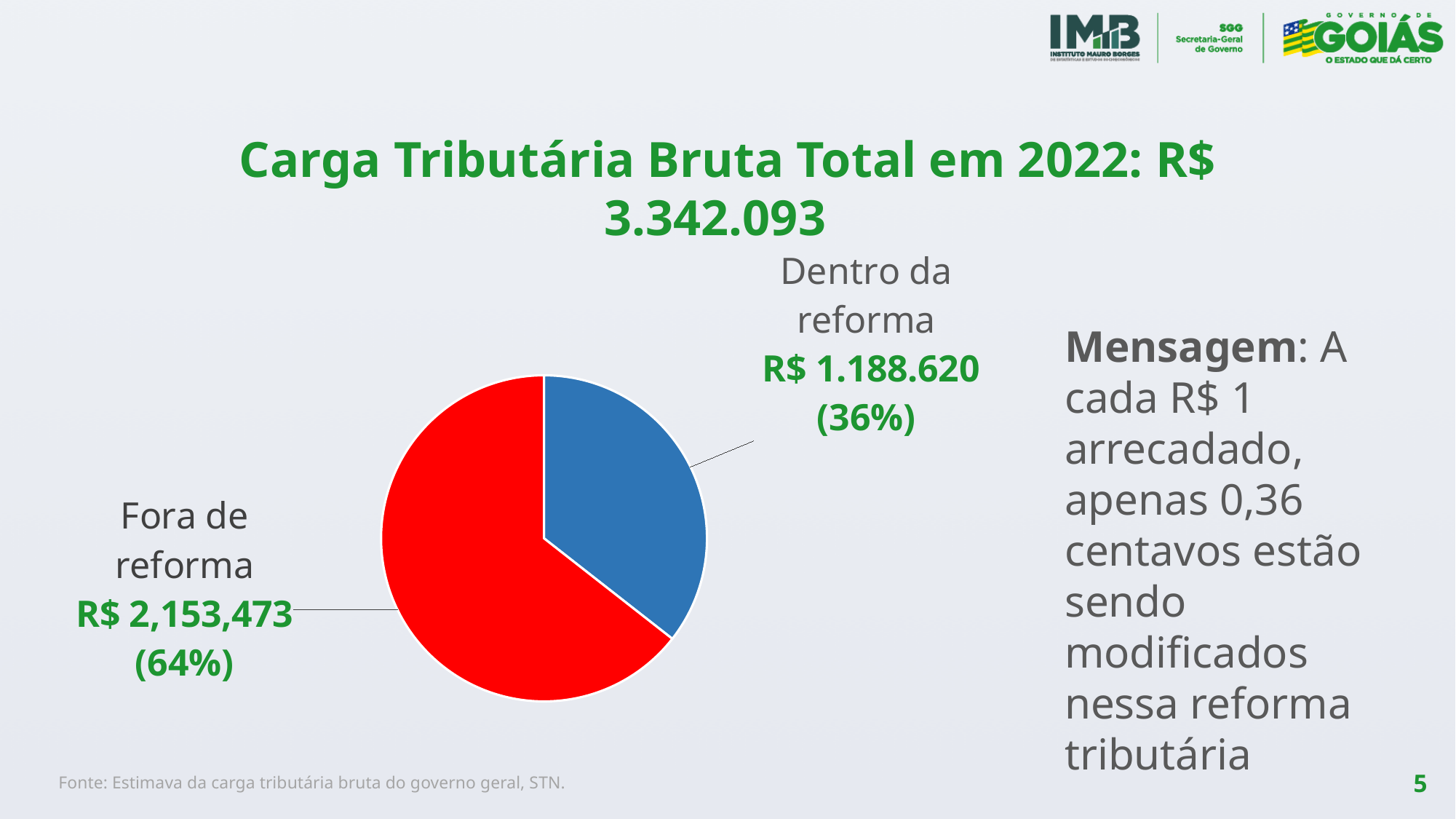
Which slice of the pie chart is the largest? Fora de reforma How many slices does the pie chart have? 2 What share of the pie does "Fora de reforma" represent? 64% Which is larger, "Dentro da reforma" or "Fora de reforma"? Fora de reforma What colour is the "Fora de reforma" slice? red What is the value for "Fora de reforma" in the pie chart? R$ 2,153,473 What is the value for "Dentro da reforma" in the pie chart? R$ 1.188.620 What kind of chart is shown on the slide? pie chart What colour is the "Dentro da reforma" slice? blue What is the total gross tax burden for 2022 stated in the chart title? R$ 3.342.093 Which slice of the pie chart is the smallest? Dentro da reforma What share of the pie does "Dentro da reforma" represent? 36%